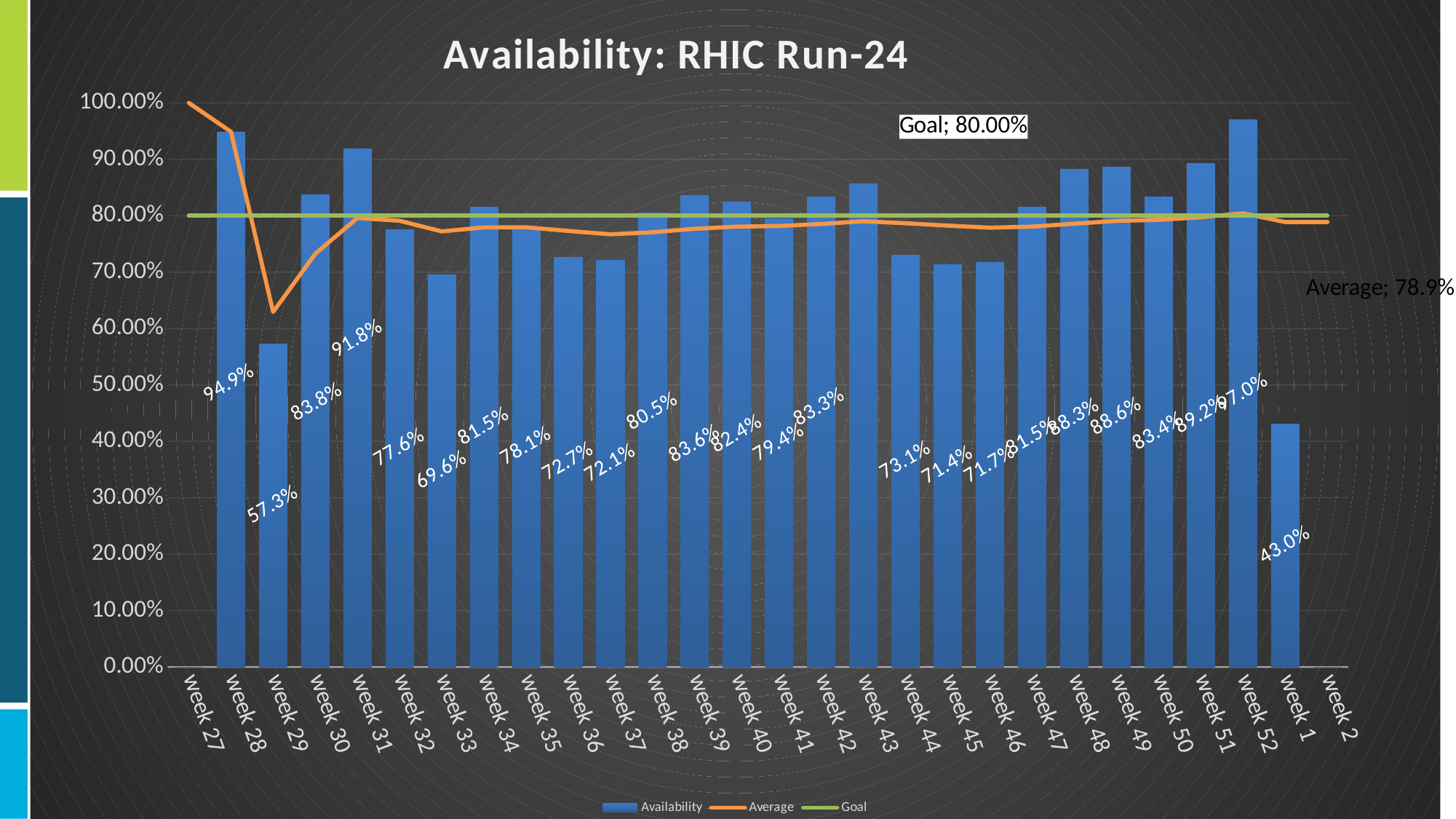
What value is shown for the Average? 78.9% What is the availability value for week 48? 88.3% What is the difference between the availability for week 52 and week 29? 39.7 percentage points How many series does the legend list? 3 Is the availability value for week 43 greater or less than 80%? greater What is the availability value for week 1? 43.0% What is the availability value for week 29? 57.3% What is the difference between the availability for week 52 and week 1? 54.0 percentage points Which week has the highest availability? week 52 Which has higher availability, week 30 or week 31? week 31 What value is shown for the Goal line? 80.00% What is the availability value for week 52? 97.0%